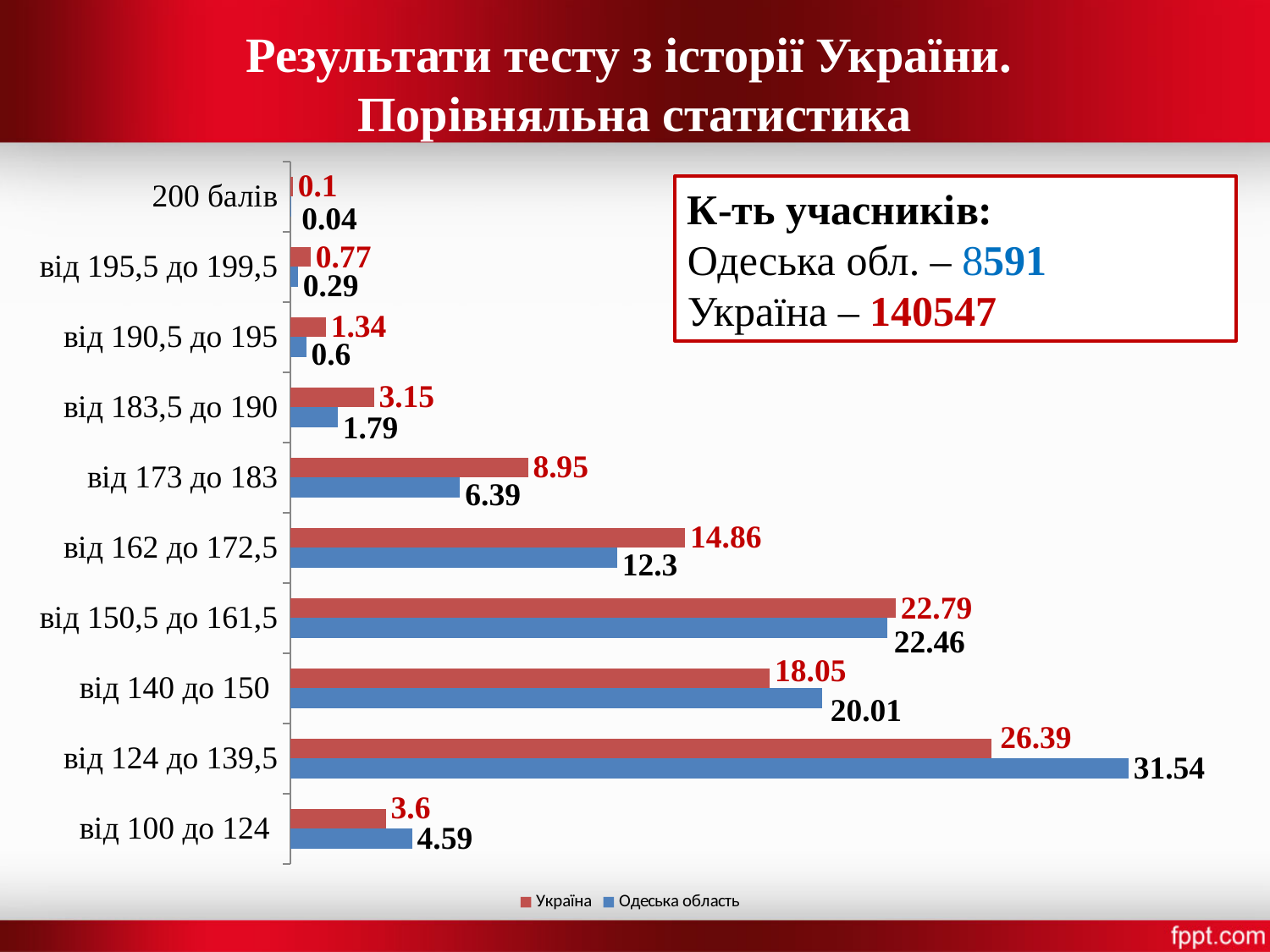
How many score categories are shown on the chart? 10 In the category "від 173 до 183", which series has the larger value, Україна or Одеська область? Україна What is the value for Одеська область in the category "200 балів"? 0.04 What is the value for Україна in the category "від 124 до 139,5"? 26.39 Which category has the lowest value for Україна? 200 балів Which category has the highest value for Одеська область? від 124 до 139,5 What is the value for Одеська область in the category "від 140 до 150"? 20.01 Which series is shown in red on the chart? Україна How many series does the legend list? 2 What type of chart is shown on the slide? Bar chart What is the difference between the Одеська область and Україна values in the category "від 124 до 139,5"? 5.15 In the category "від 100 до 124", which series has the larger value, Україна or Одеська область? Одеська область